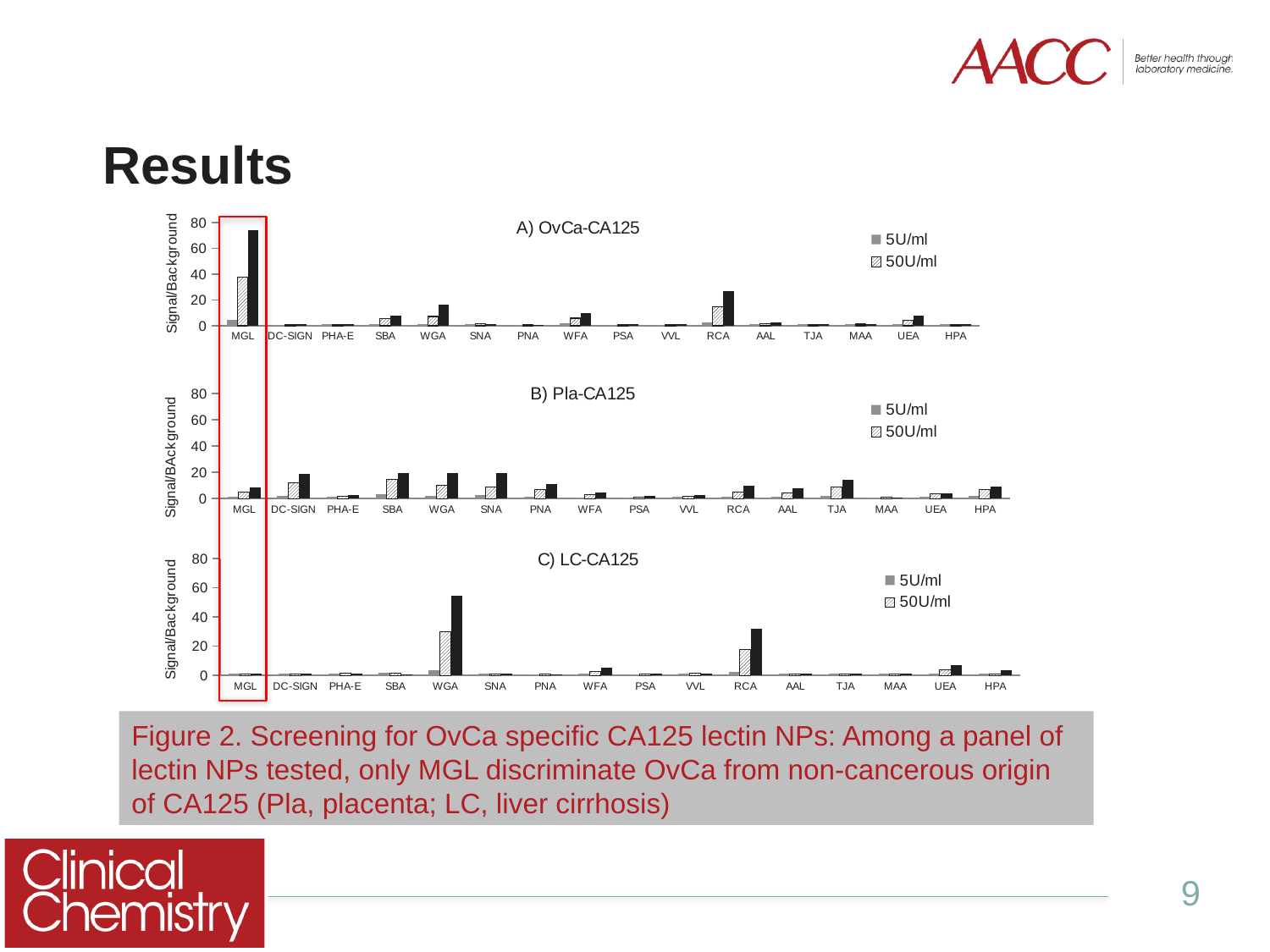
In chart A) OvCa-CA125, which lectin has the highest Signal/Background value? MGL What kind of chart is chart A) OvCa-CA125? bar chart In chart A) OvCa-CA125, is the tallest bar for RCA greater or less than 20? greater In chart C) LC-CA125, which lectin has the highest Signal/Background value? WGA In chart C) LC-CA125, which has the larger tallest bar, WGA or RCA? WGA In chart B) Pla-CA125, is the tallest bar for MGL greater or less than 20? less In chart C) LC-CA125, is the tallest bar for WGA greater or less than 40? greater How many series does the legend of chart B) Pla-CA125 list? 2 How many lectin categories are shown on the x axis of chart A) OvCa-CA125? 16 In chart A) OvCa-CA125, which has the larger tallest bar, MGL or RCA? MGL What is the y-axis label of chart C) LC-CA125? Signal/Background